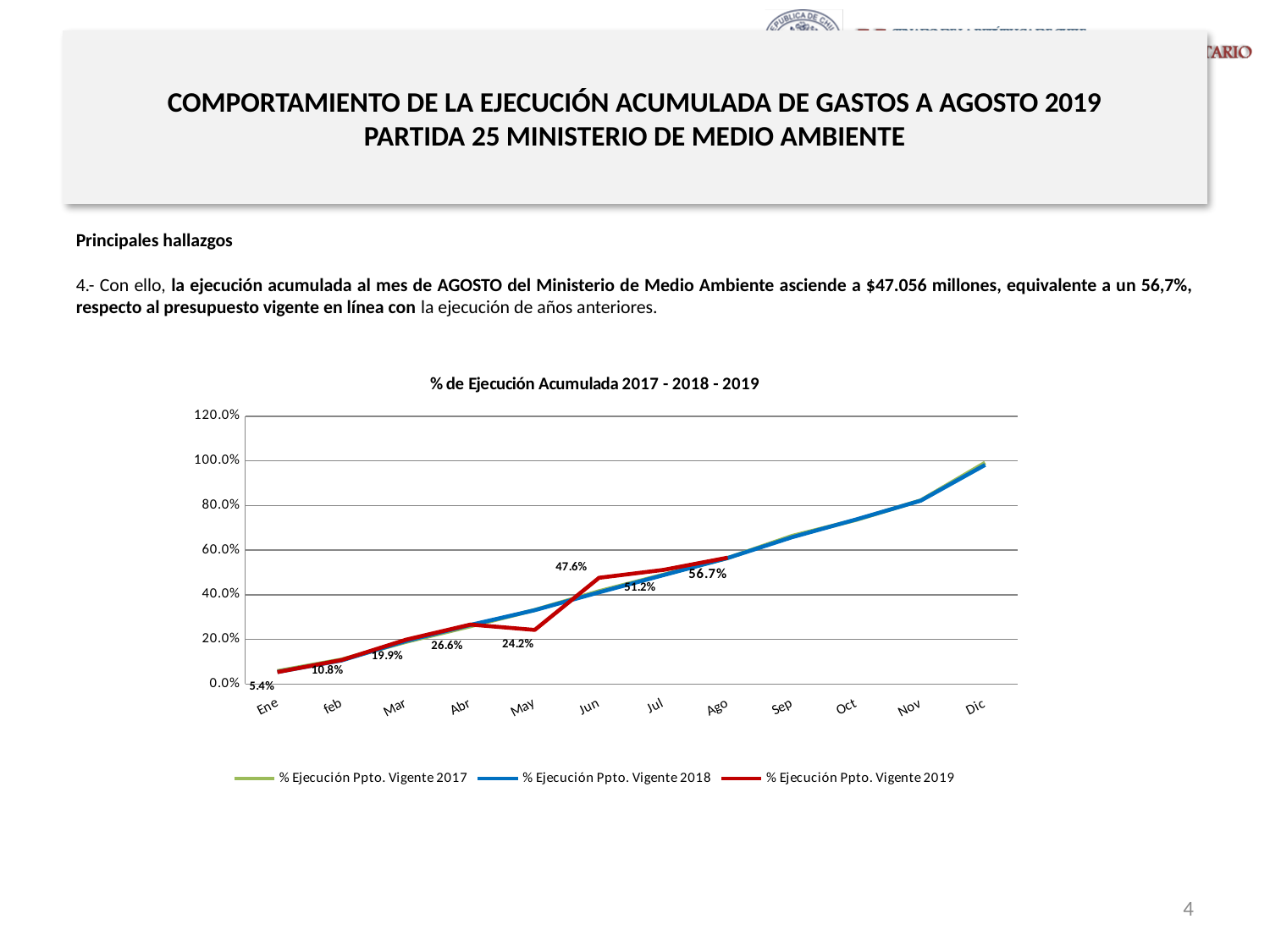
Is the value for % Ejecución Ppto. Vigente 2018 in Dic greater or less than 80.0%? greater What is the labelled value for % Ejecución Ppto. Vigente 2019 in Ago? 56.7% What is the difference between the 2019 values labelled for Ago and Jul? 5.5% What type of chart is shown on the slide? Line chart What is the labelled value for % Ejecución Ppto. Vigente 2019 in Ene? 5.4% What is the labelled value for % Ejecución Ppto. Vigente 2019 in Jun? 47.6% What is the title of the chart? % de Ejecución Acumulada 2017 - 2018 - 2019 Among the labelled 2019 values, which month has the lowest value? Ene Which is larger for the 2019 series: the value in Abr or the value in May? Abr How many months are shown on the x axis of the chart? 12 How many series does the chart legend list? 3 Does the % Ejecución Ppto. Vigente 2018 line rise or fall from Ene to Dic? Rise